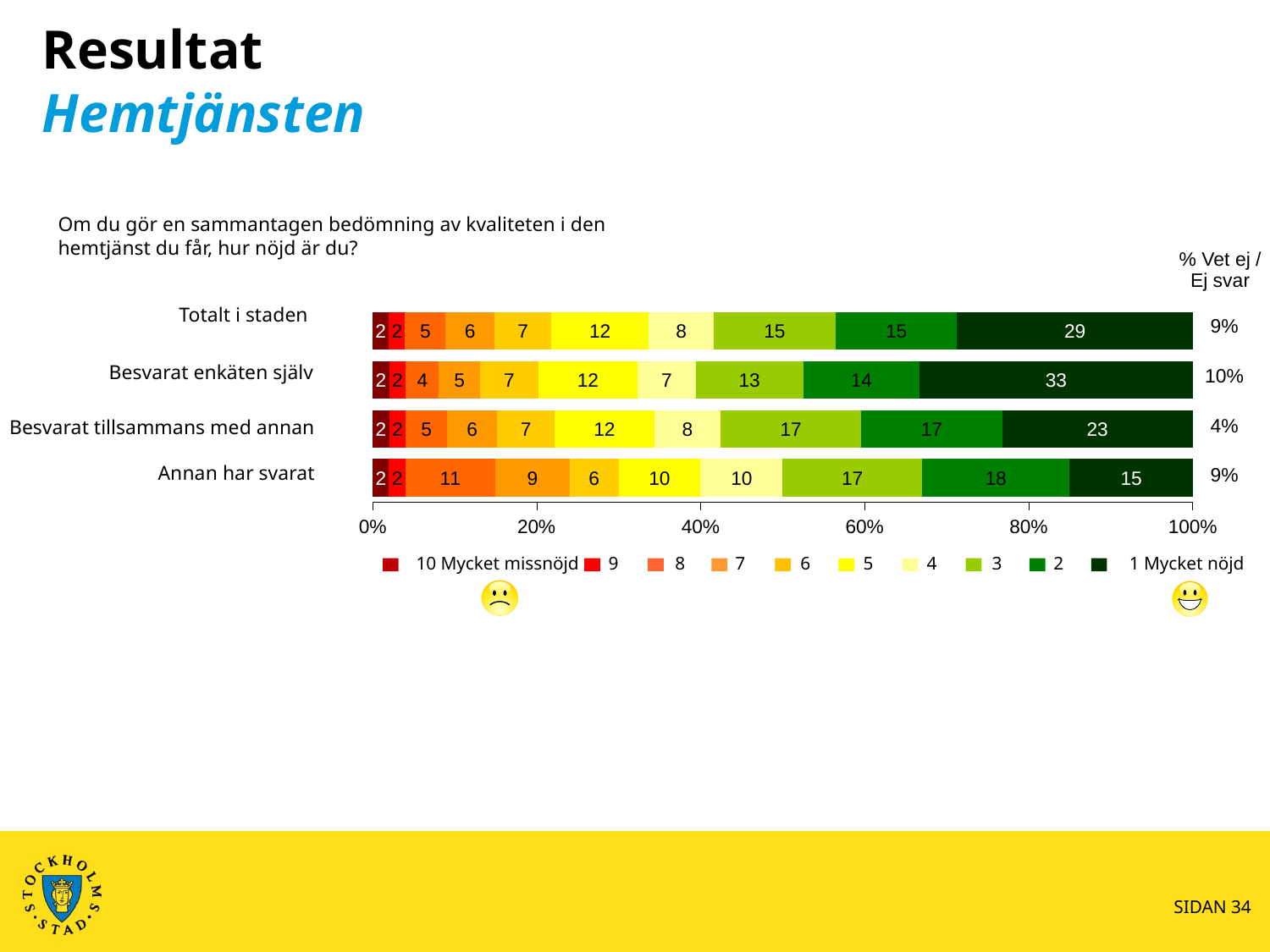
What is the value of the "1 Mycket nöjd" segment for "Besvarat enkäten själv"? 33 How many categories (bars) does the chart show? 4 Which is larger: the "8" segment for "Annan har svarat" or the "8" segment for "Totalt i staden"? Annan har svarat What is the value of the "5" segment for "Totalt i staden"? 12 What kind of chart is shown on the slide? Stacked bar chart What is the label of the first legend entry? 10 Mycket missnöjd Which category has the lowest value for the "1 Mycket nöjd" segment? Annan har svarat Which category has the highest value for the "1 Mycket nöjd" segment? Besvarat enkäten själv What is the "% Vet ej / Ej svar" value shown for "Besvarat tillsammans med annan"? 4% How many series does the legend list? 10 What is the difference between the "1 Mycket nöjd" values for "Besvarat enkäten själv" and "Annan har svarat"? 18 What is the value of the "3" segment for "Annan har svarat"? 17